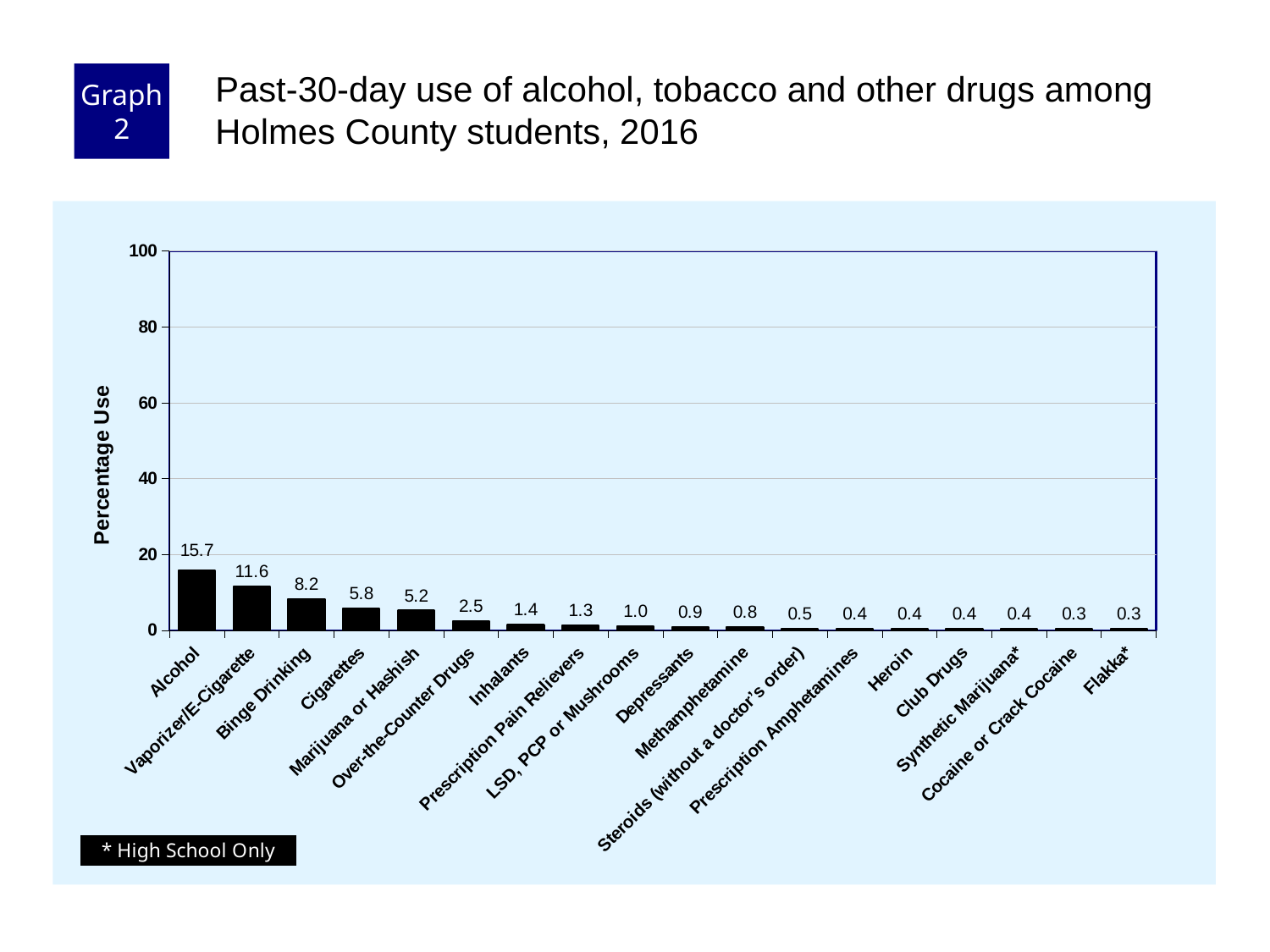
What is the percentage use for Heroin? 0.4 What is the difference in percentage use between Binge Drinking and Cigarettes? 2.4 What is the percentage use for Vaporizer/E-Cigarette? 11.6 Is the value for Alcohol greater or less than 20? less What is the difference in percentage use between Alcohol and Vaporizer/E-Cigarette? 4.1 What is the percentage use for Alcohol? 15.7 What is the label of the y axis? Percentage Use What is the percentage use for Marijuana or Hashish? 5.2 Which has a higher percentage use, Inhalants or Over-the-Counter Drugs? Over-the-Counter Drugs How many categories are shown on the x axis? 18 What kind of chart is shown on the slide? Bar chart Which category has the highest percentage use? Alcohol